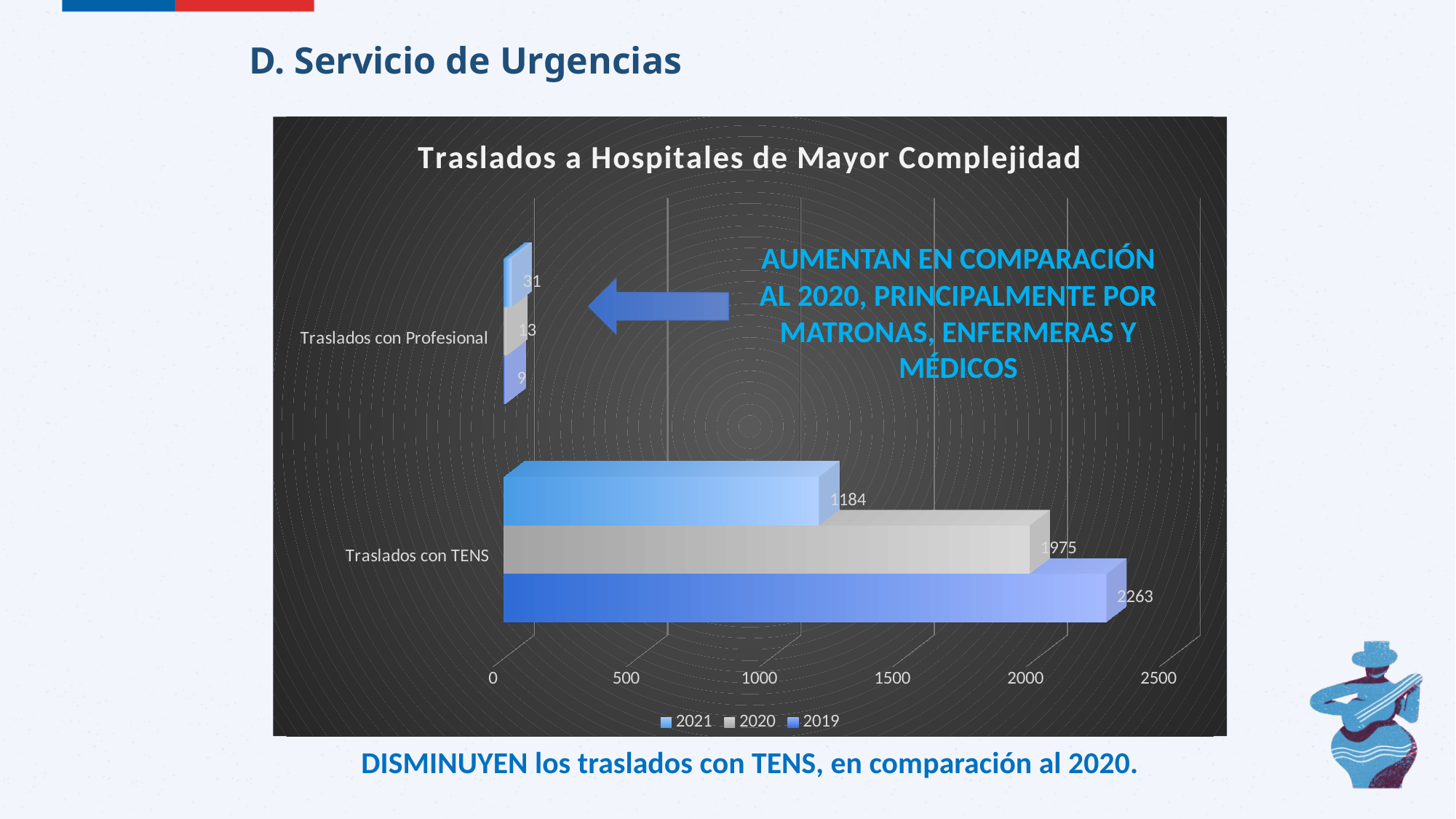
Which is larger for Traslados con Profesional, the 2021 value or the 2020 value? 2021 What is the value for Traslados con TENS in 2019? 2263 What is the value for Traslados con TENS in 2021? 1184 What kind of chart is shown on the slide? Bar chart Is the value for Traslados con TENS in 2020 greater or less than 1500? greater What is the value for Traslados con Profesional in 2020? 13 What is the value for Traslados con Profesional in 2021? 31 How many categories are shown on the chart? 2 Which year has the highest value for Traslados con TENS? 2019 How many series does the legend list? 3 What is the difference between the 2020 and 2021 values for Traslados con TENS? 791 Which year has the lowest value for Traslados con Profesional? 2019